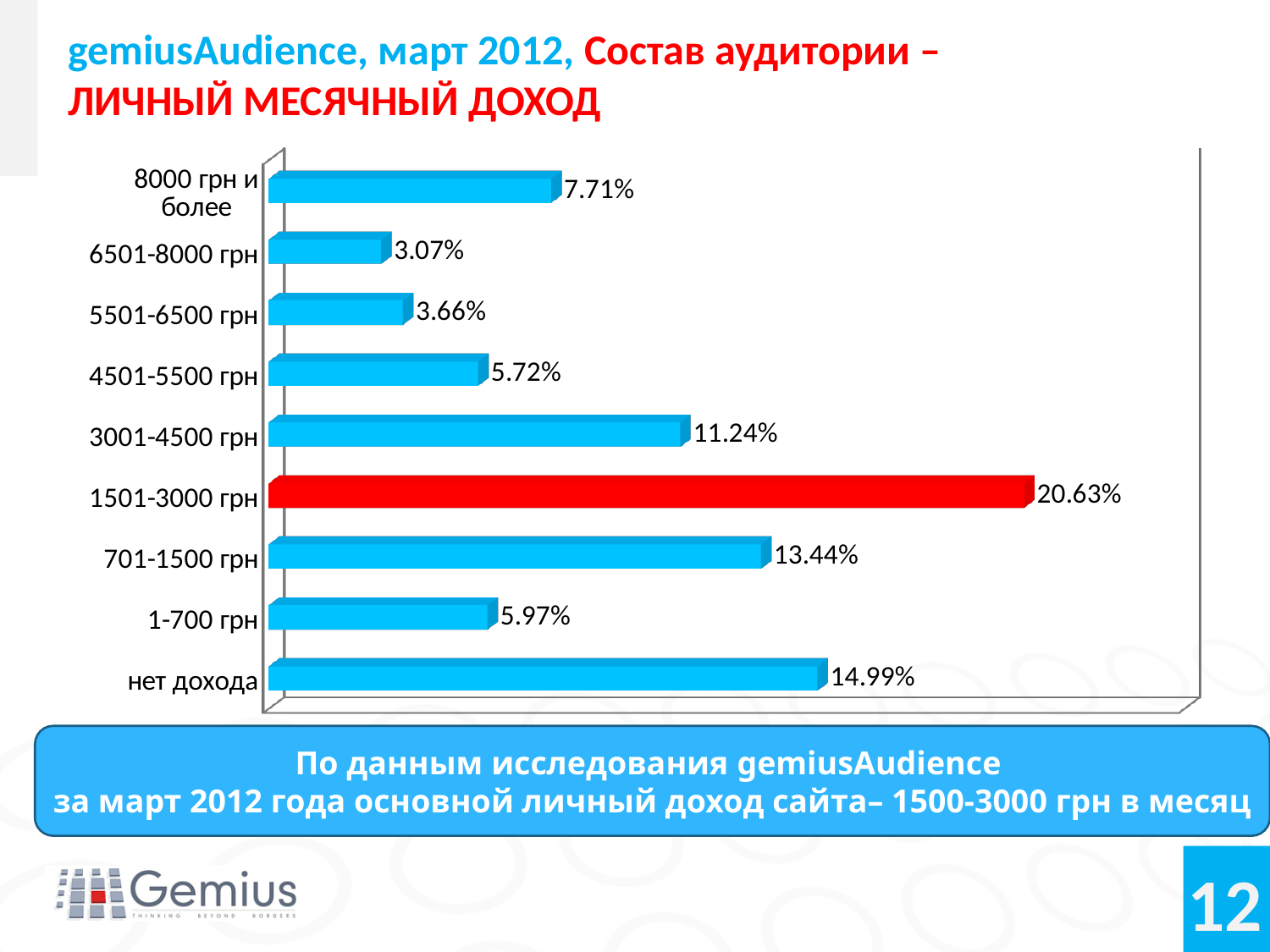
Which category has the lowest value? 6501-8000 грн What is the value for the нет дохода category? 14.99% What is the value for the 8000 грн и более category? 7.71% Which is larger, the value for 1-700 грн or the value for 4501-5500 грн? 1-700 грн What is the difference between the values for 1501-3000 грн and 701-1500 грн? 7.19% What is the value for the 3001-4500 грн category? 11.24% What is the difference between the values for нет дохода and 3001-4500 грн? 3.75% How many income categories are shown in the chart? 9 What is the value for the 1501-3000 грн category? 20.63% Which category has the highest value? 1501-3000 грн What kind of chart is shown on the slide? Bar chart Which bar is coloured red instead of blue? 1501-3000 грн